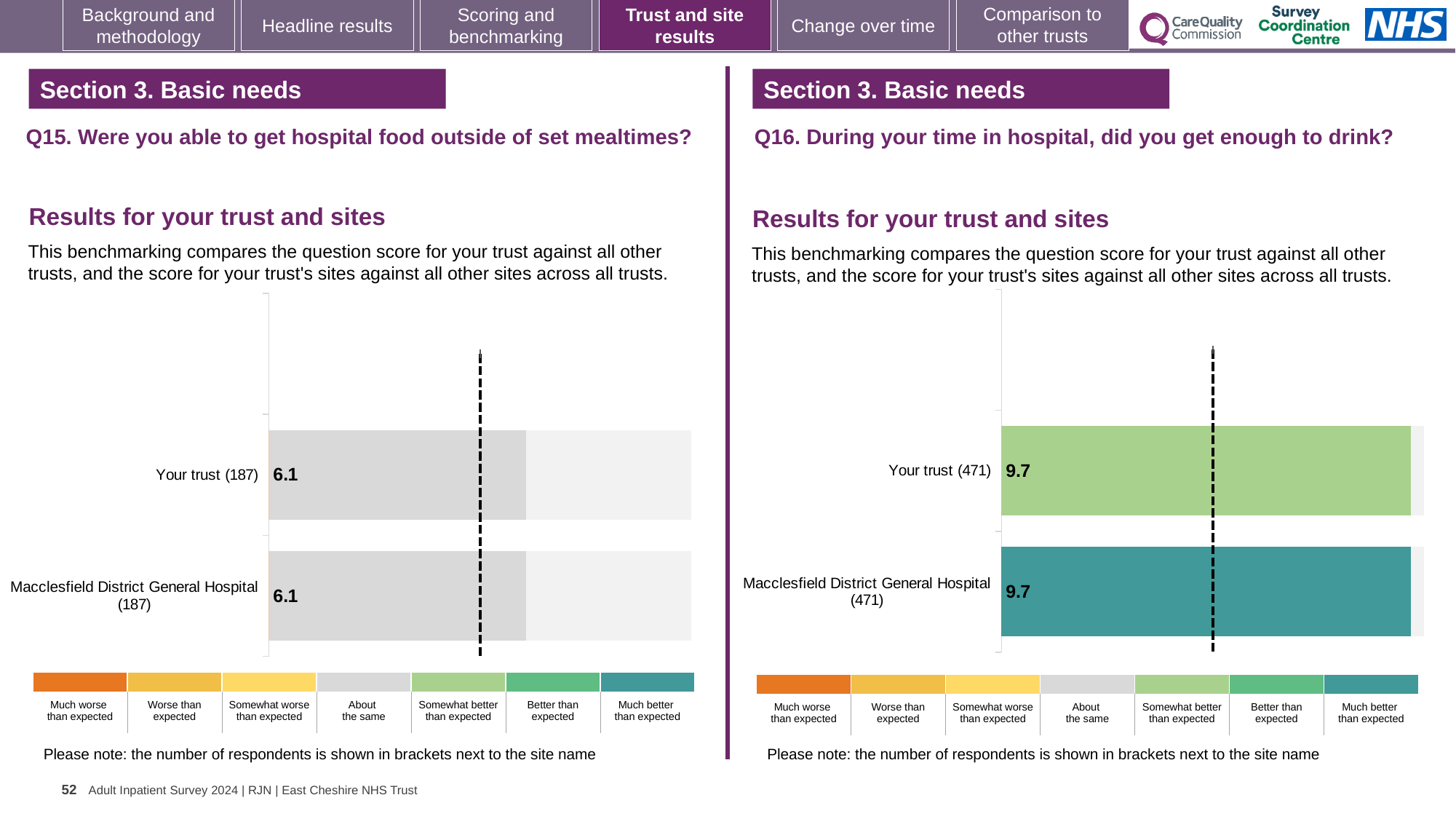
In the Q15 chart on the left, what is the score for Macclesfield District General Hospital? 6.1 In the Q15 chart on the left, what is the score for Your trust? 6.1 What kind of chart is used for Q16 on the right? Bar chart In the Q16 chart on the right, what is the score for Macclesfield District General Hospital? 9.7 In the Q16 chart on the right, what is the score for Your trust? 9.7 How many bars are plotted in the Q16 chart on the right? 2 In the Q15 chart on the left, what is the difference between the score for Your trust and the score for Macclesfield District General Hospital? 0 In the Q16 chart on the right, how many respondents are shown in brackets for Macclesfield District General Hospital? 471 In the Q16 chart on the right, what is the difference between the score for Your trust and the score for Macclesfield District General Hospital? 0 In the Q16 chart on the right, which benchmark category does the colour of the Macclesfield District General Hospital bar correspond to in the legend? Much better than expected How many bars are plotted in the Q15 chart on the left? 2 In the Q15 chart on the left, how many respondents are shown in brackets for Your trust? 187